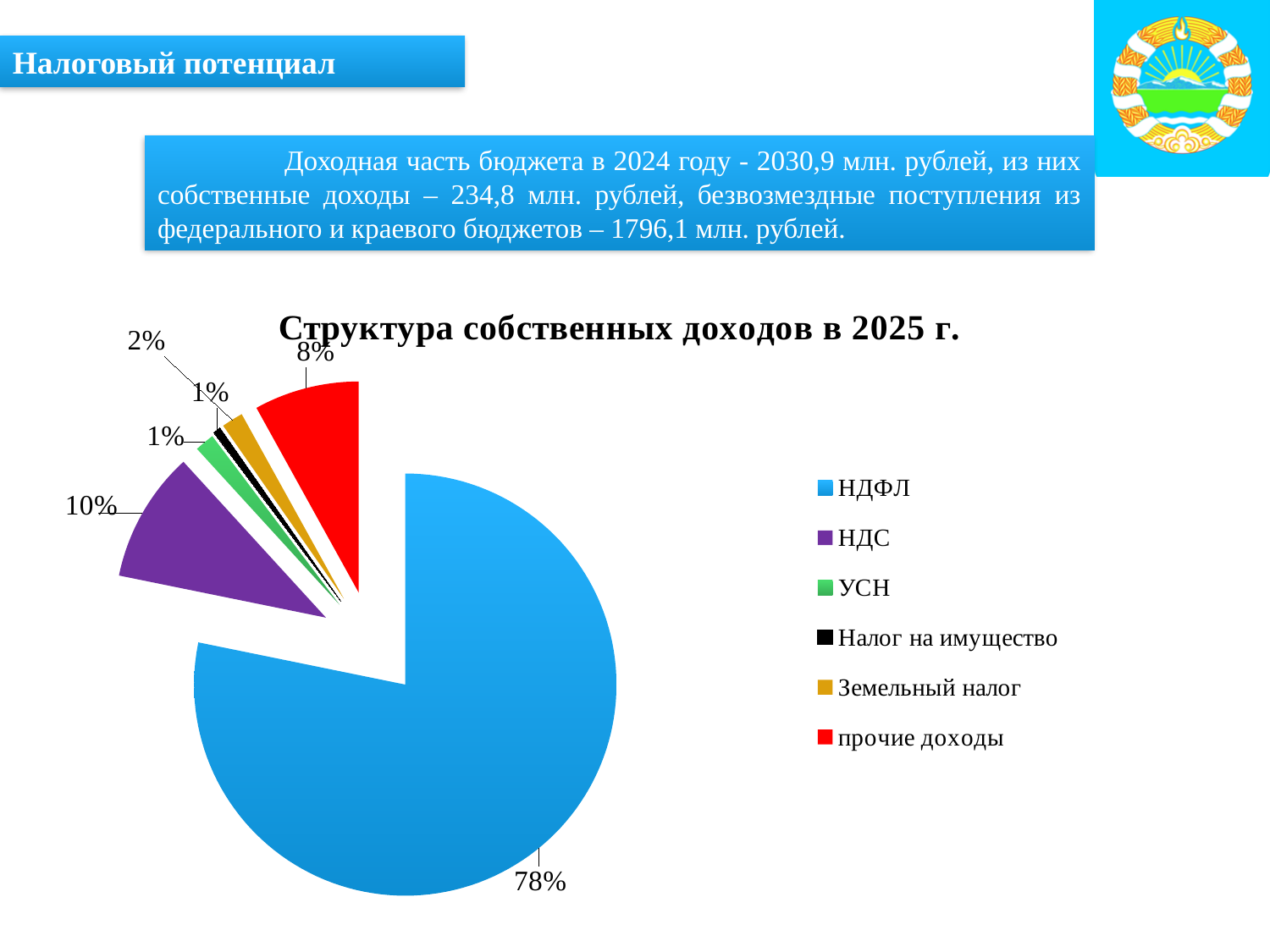
What share of the pie does НДС have? 10% What kind of chart is shown on the slide? pie chart What colour is the slice for прочие доходы? red What is the difference between the share of НДФЛ and the share of НДС? 68% Which category has the largest slice of the pie? НДФЛ Which is larger, the share of НДС or the share of прочие доходы? НДС What share of the pie does Земельный налог have? 2% What share of the pie does УСН have? 1% What is the title of the chart? Структура собственных доходов в 2025 г. How many categories does the legend of the pie chart list? 6